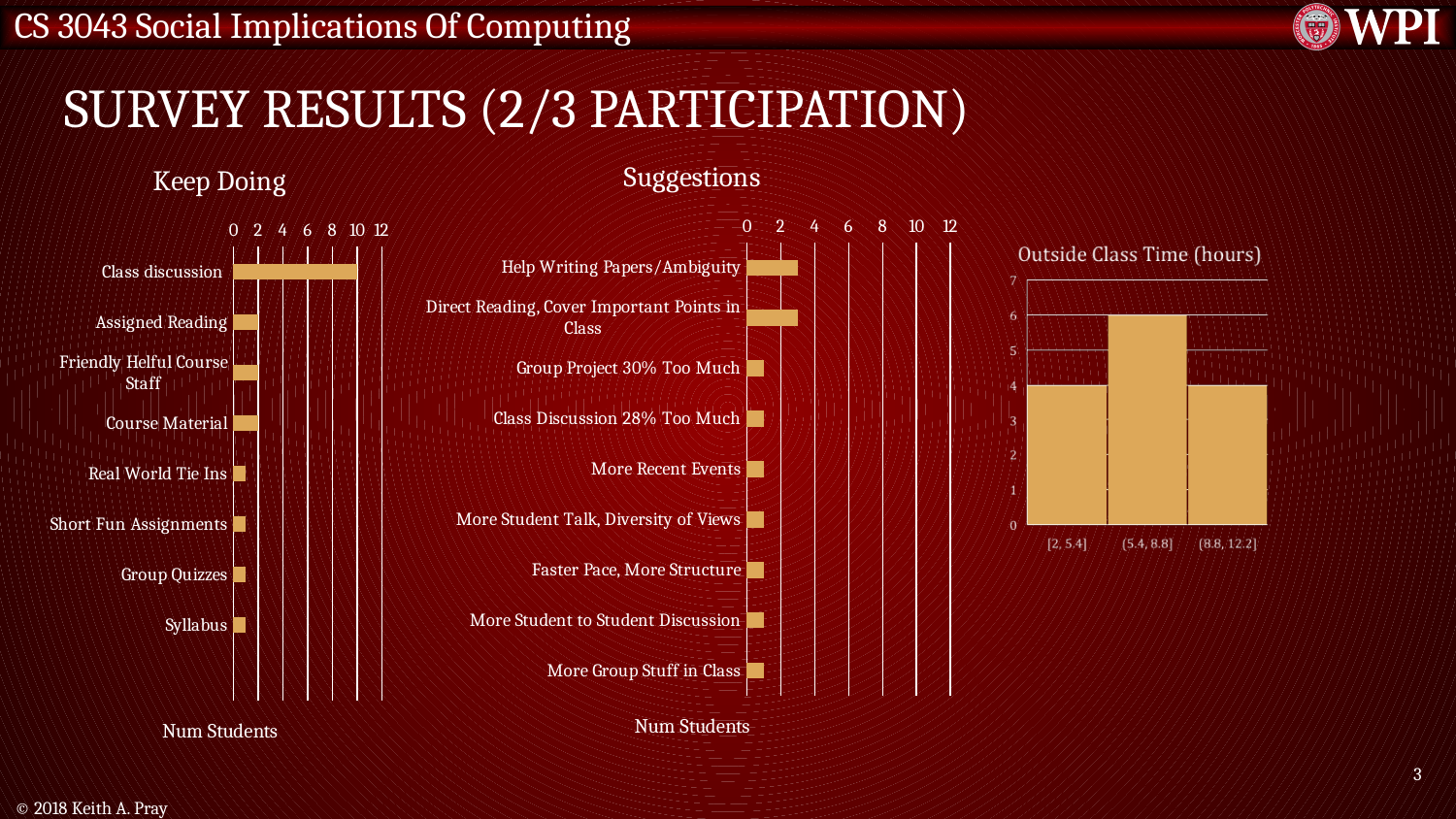
In the Suggestions chart, is the value for Help Writing Papers/Ambiguity greater or less than 2? greater In the Suggestions chart, which is larger: Help Writing Papers/Ambiguity or More Recent Events? Help Writing Papers/Ambiguity In the Outside Class Time (hours) chart, what is the value for the (5.4, 8.8] bin? 6 How many categories are shown in the Suggestions chart? 9 In the Outside Class Time (hours) chart, which bin has the highest value? (5.4, 8.8] How many bins are shown in the Outside Class Time (hours) chart? 3 In the Outside Class Time (hours) chart, what is the difference between the (5.4, 8.8] bin and the [2, 5.4] bin? 2 What is the x-axis label of the Keep Doing chart? Num Students In the Keep Doing chart, which category has the highest number of students? Class discussion How many categories are shown in the Keep Doing chart? 8 In the Keep Doing chart, is the value for Class discussion greater or less than 8? greater In the Keep Doing chart, is the value for Syllabus greater or less than 2? less